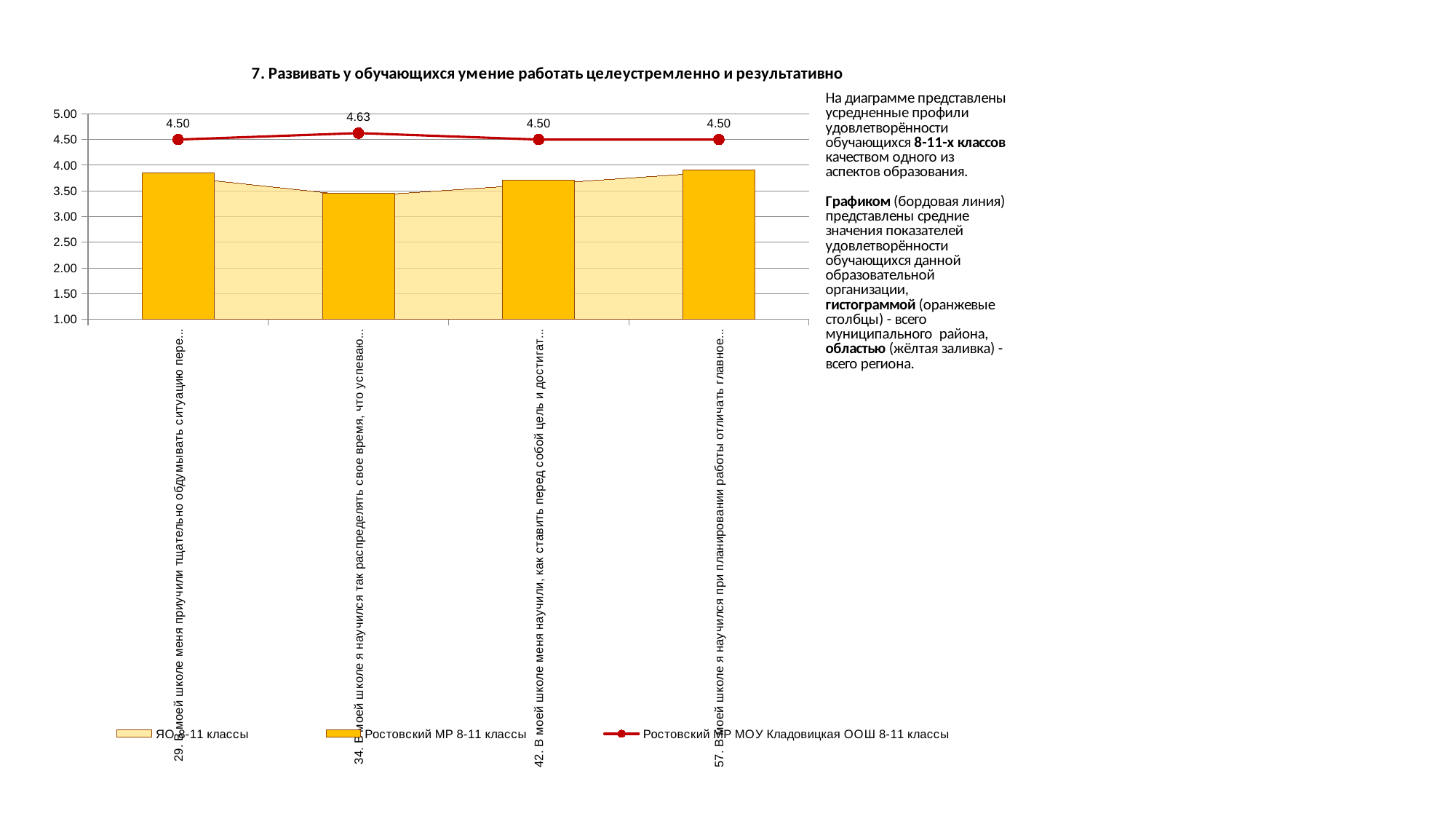
Is the Ростовский МР 8-11 классы bar for category 29 greater or less than 3.50? greater Which Ростовский МР 8-11 классы bar is taller: category 57 or category 34? 57 Which is larger: the line value for category 34 or for category 57? 34 What colour is the Ростовский МР МОУ Кладовицкая ООШ 8-11 классы line? Red (бордовая) What is the difference between the line values for categories 34 and 42? 0.13 How many categories are shown on the x axis? 4 What is the value of the Ростовский МР МОУ Кладовицкая ООШ 8-11 классы line for the category labelled 34? 4.63 Which category has the lowest Ростовский МР 8-11 классы bar? 34 How many series does the legend list? 3 What is the value of the Ростовский МР МОУ Кладовицкая ООШ 8-11 классы line for the category labelled 29? 4.50 For which category does the Ростовский МР МОУ Кладовицкая ООШ 8-11 классы line reach its highest value? 34 Is the Ростовский МР 8-11 классы bar for category 34 greater or less than 4.00? less